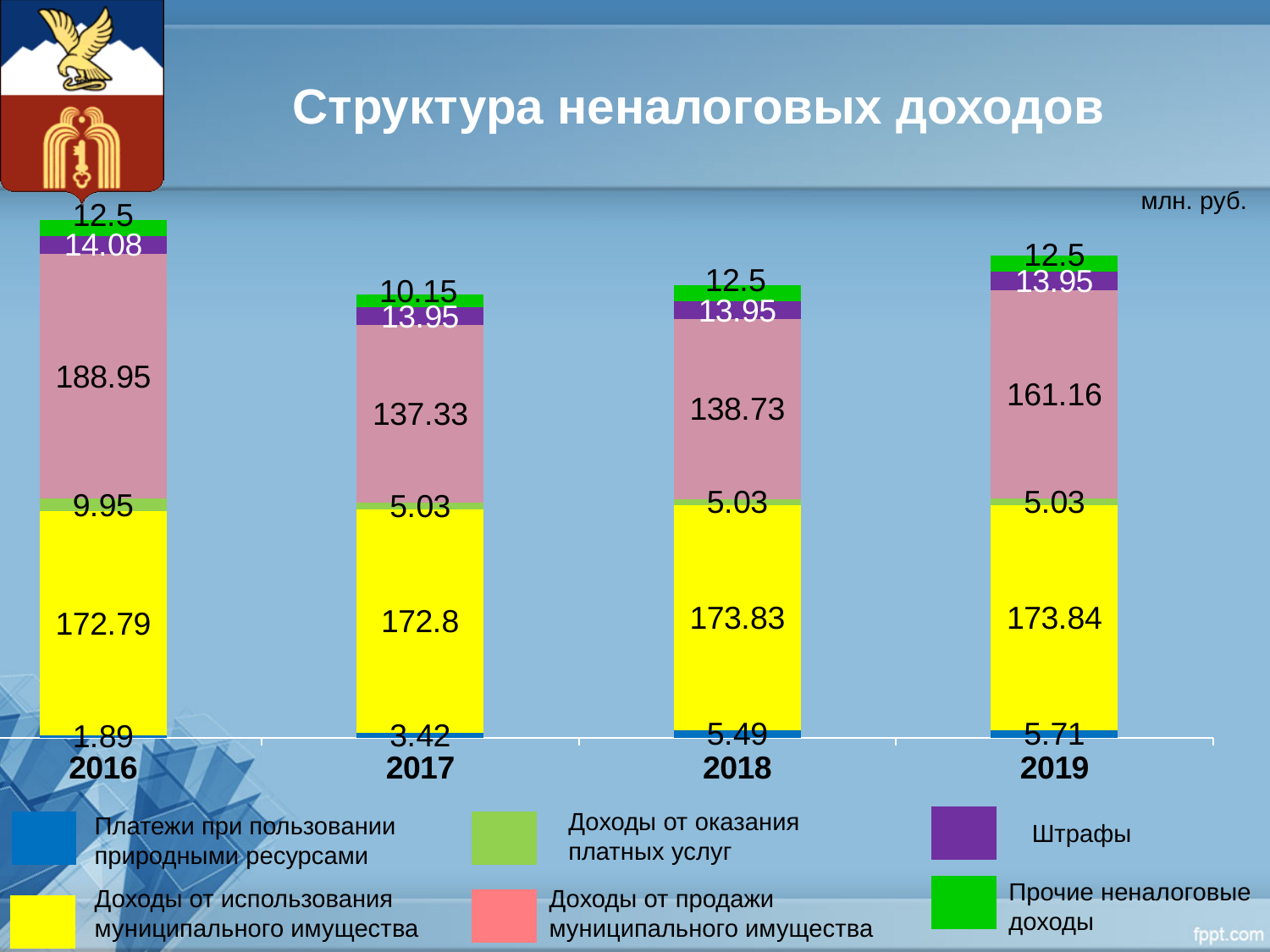
What is the total of the stacked bar for 2017? 342.68 What is the value of «Доходы от продажи муниципального имущества» in 2016? 188.95 What unit of measurement is indicated on the chart? млн. руб. In which year is «Доходы от оказания платных услуг» the highest? 2016 What type of chart is shown on the slide? Stacked bar chart What is the value of «Платежи при пользовании природными ресурсами» in 2019? 5.71 What is the value of «Доходы от использования муниципального имущества» in 2018? 173.83 In which year is «Доходы от продажи муниципального имущества» the lowest? 2017 What is the value of «Прочие неналоговые доходы» in 2017? 10.15 What is the difference between «Доходы от продажи муниципального имущества» in 2016 and in 2019? 27.79 How many series does the legend list? 6 Which is larger: «Штрафы» in 2016 or «Штрафы» in 2018? 2016